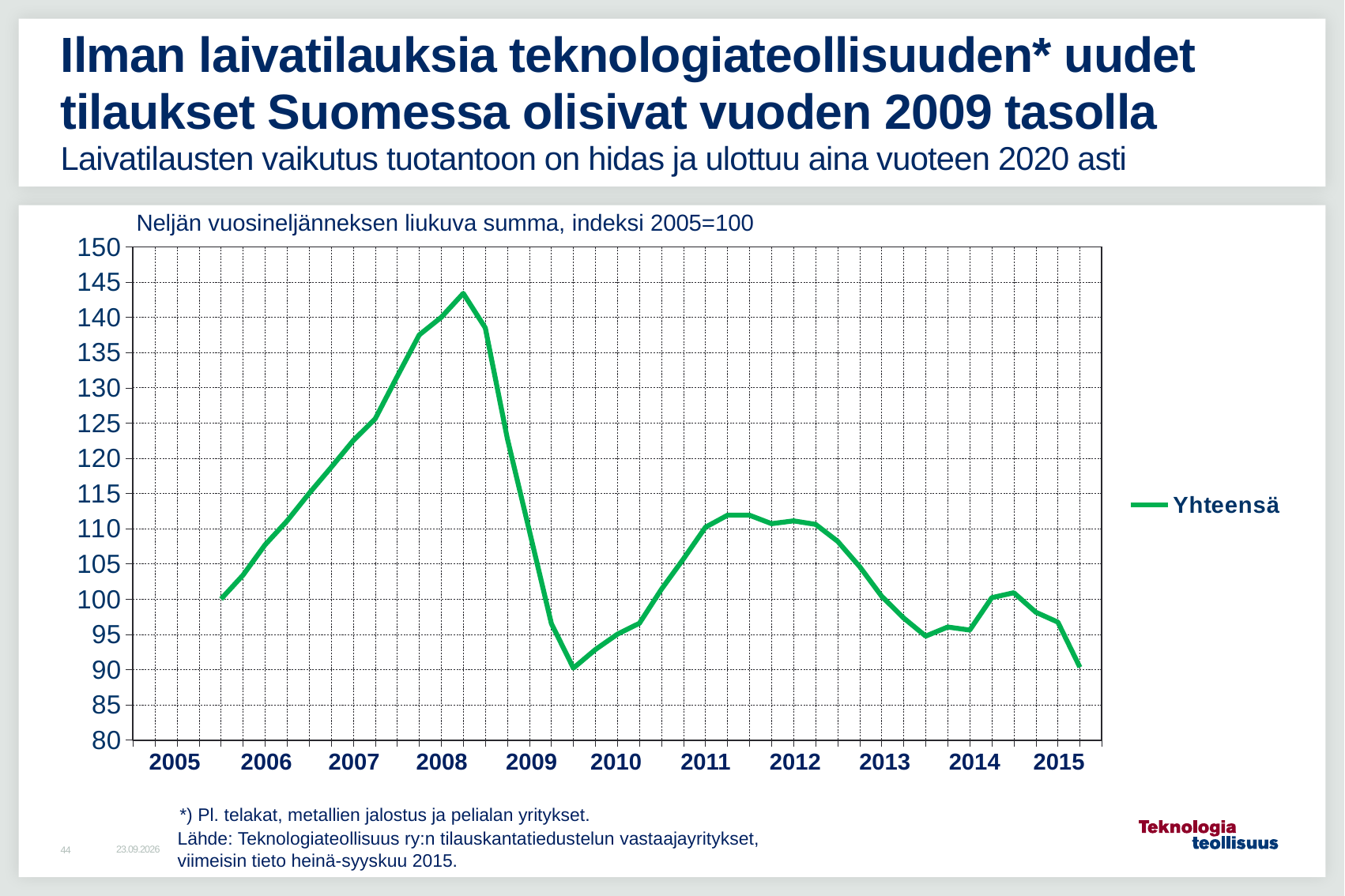
What is the name of the series shown in the legend? Yhteensä Is the lowest value of the line in 2009 greater or less than 95? less Does the Yhteensä line rise or fall between 2011 and 2013? fall How many years are labelled on the x axis? 11 Is the value of the line at the end of 2015 greater or less than 95? less What kind of chart is shown on the slide? line chart Does the Yhteensä line rise or fall between 2005 and 2008? rise What is the index value at the start of the series in 2005? 100 In which year does the Yhteensä line reach its highest value? 2008 What colour is the Yhteensä line? green How many series does the legend list? 1 Is the peak value of the line in 2008 greater or less than 140? greater